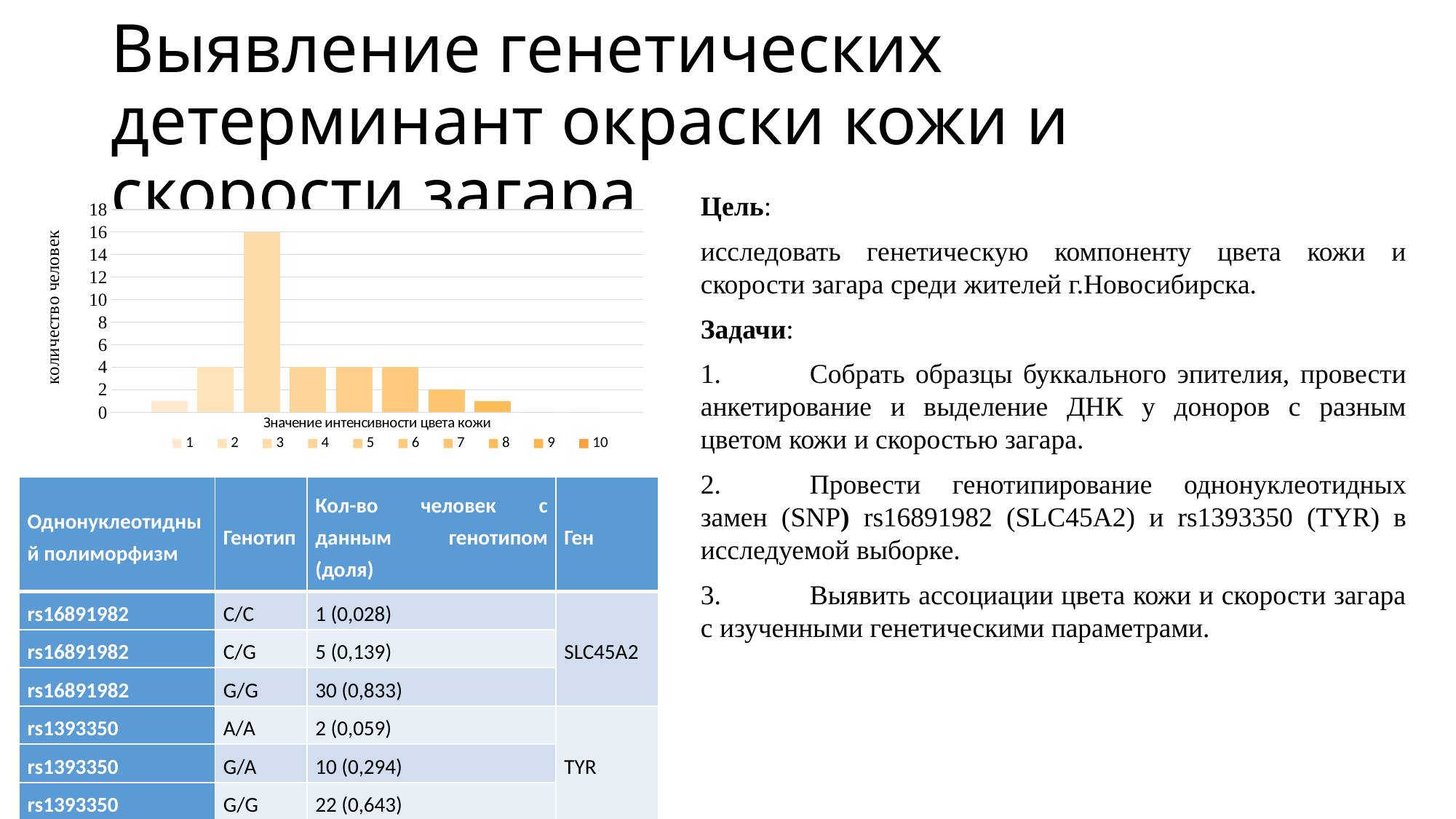
Is the value for category 1 in the bar chart greater or less than 2? less Which category has the highest bar in the chart? 3 What is the value for category 6 in the bar chart? 4 What is the value for category 2 in the bar chart? 4 What is the value for category 7 in the bar chart? 2 Is the value for category 3 in the bar chart greater or less than 14? greater Which is larger in the bar chart, the value for category 3 or the value for category 4? 3 What kind of chart is shown on the slide? bar chart How many entries does the legend of the bar chart list? 10 What is the title of the vertical axis of the bar chart? количество человек What is the difference between the value for category 3 and the value for category 5 in the bar chart? 12 What is the value for category 3 in the bar chart? 16